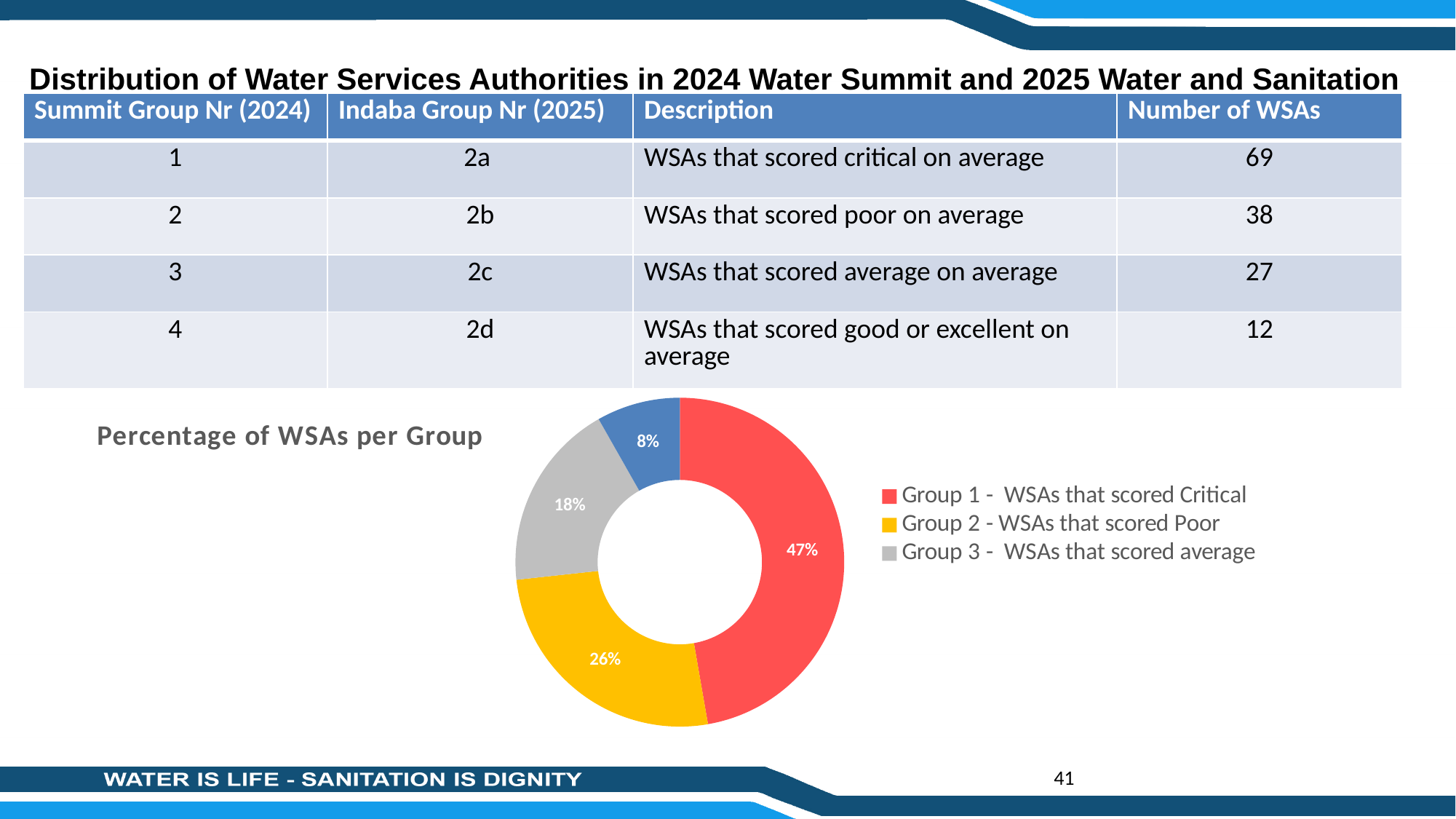
What colour represents Group 2 - WSAs that scored Poor in the chart? yellow What percentage of WSAs is shown for Group 3 - WSAs that scored average? 18% What percentage of WSAs is shown for Group 2 - WSAs that scored Poor? 26% How many slices does the chart have? 4 How many entries does the chart legend list? 3 What kind of chart is shown on the slide? doughnut chart What is the title of the chart? Percentage of WSAs per Group What is the difference in percentage points between Group 1 - WSAs that scored Critical and Group 2 - WSAs that scored Poor? 21% What percentage of WSAs is shown for Group 1 - WSAs that scored Critical? 47% Which group has the largest share of the chart? Group 1 - WSAs that scored Critical What is the smallest percentage shown on the chart? 8% Which has a larger share, Group 2 - WSAs that scored Poor or Group 3 - WSAs that scored average? Group 2 - WSAs that scored Poor